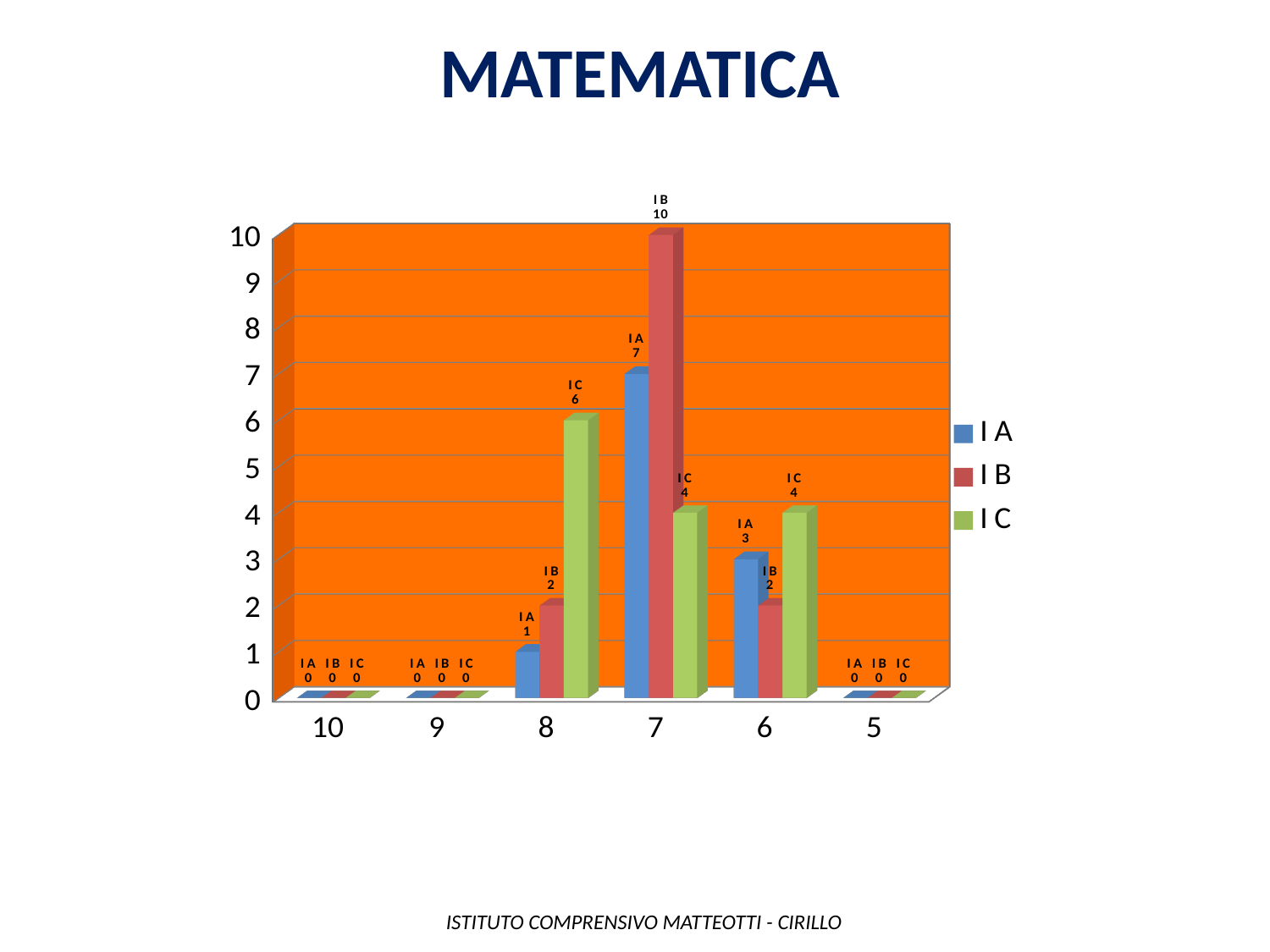
What is the difference between I B and I A at grade 7? 3 What is the value for I A at grade 6? 3 What is the value for I B at grade 7? 10 What is the value for I C at grade 8? 6 How many series does the legend list? 3 Which grade category has the highest value for I A? 7 Which is larger at grade 6, I A or I C? I C What kind of chart is shown? bar chart Which grade category has the highest value for I C? 8 What is the title of the slide? MATEMATICA How many grade categories are shown on the x axis? 6 What is the value for I A at grade 8? 1